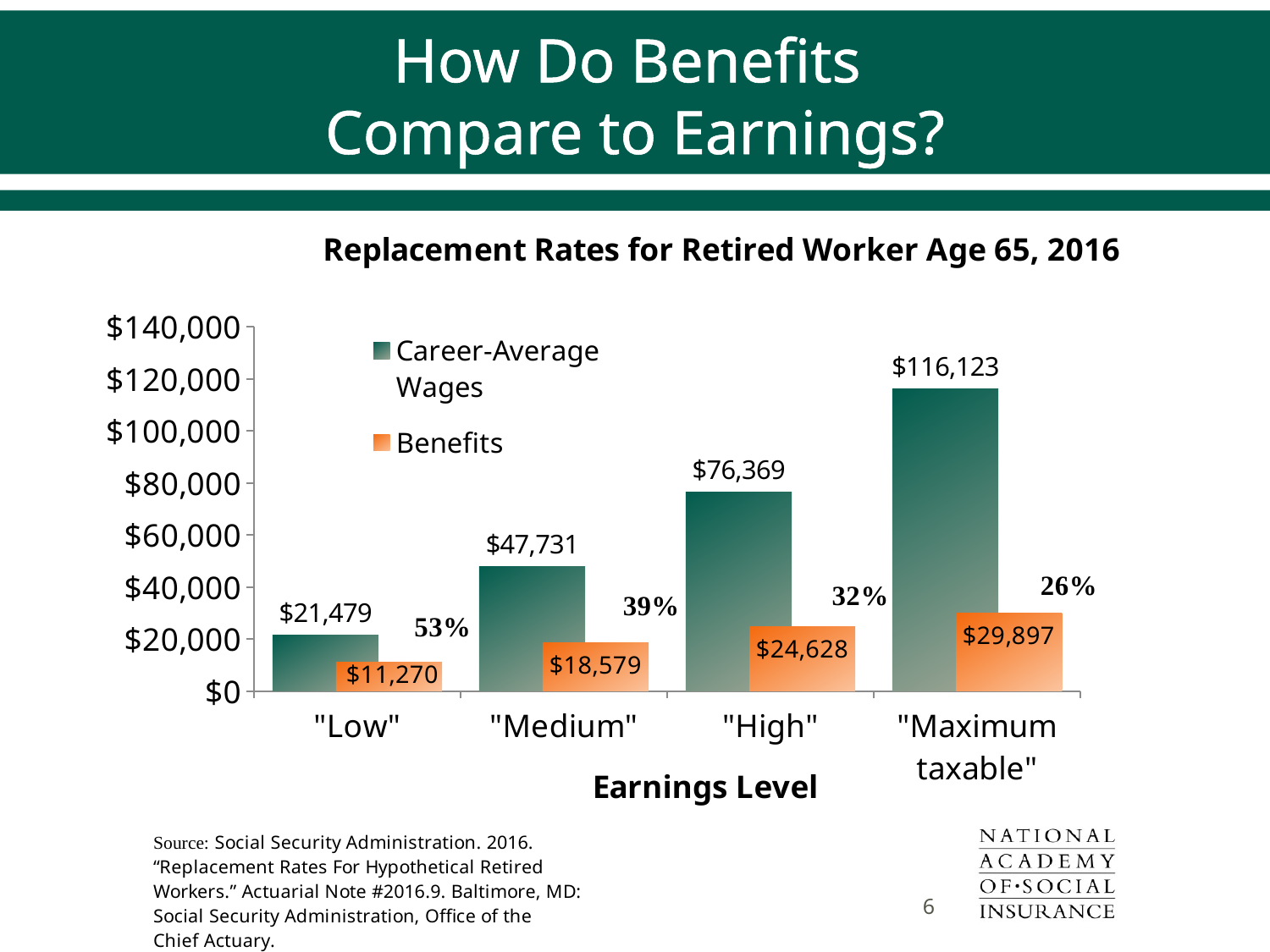
How many earnings levels are shown on the x axis? 4 What is the Career-Average Wages value for the "Maximum taxable" earnings level? $116,123 What is the Career-Average Wages value for the "High" earnings level? $76,369 Is the Career-Average Wages value for "Medium" greater or less than $40,000? greater How many series does the legend list? 2 Which is larger: Benefits for "Maximum taxable" or Career-Average Wages for "Low"? Benefits for "Maximum taxable" Which earnings level has the lowest Benefits value? "Low" What kind of chart is shown on the slide? bar chart What is the Benefits value for the "Medium" earnings level? $18,579 Which earnings level has the highest Career-Average Wages value? "Maximum taxable" What replacement rate percentage is shown for the "High" earnings level? 32% What is the difference between Career-Average Wages and Benefits for the "Low" earnings level? $10,209